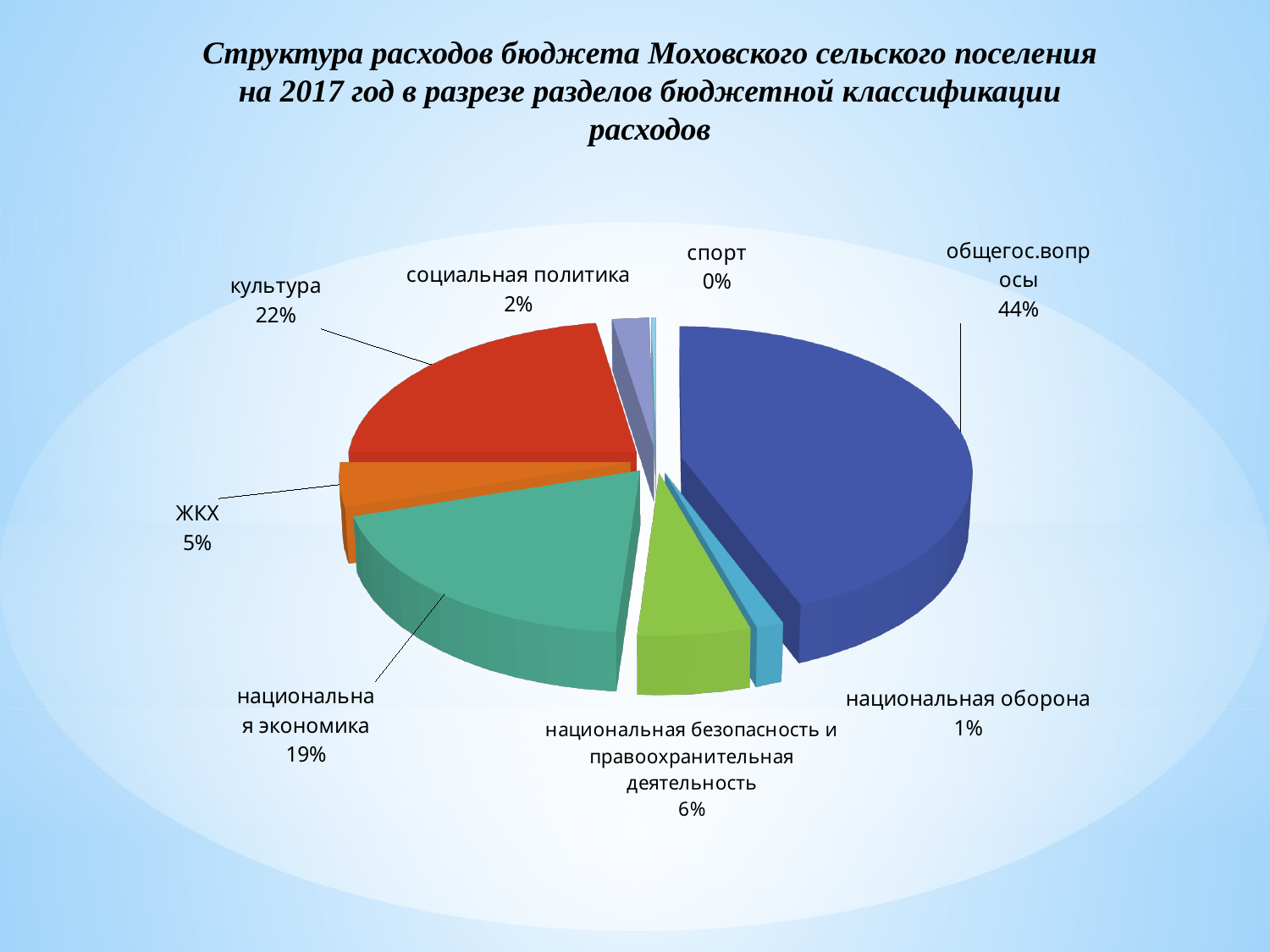
Which category has the smallest share of the pie? спорт What share of the budget expenditure goes to национальная экономика? 19% What share is shown for социальная политика? 2% What is the difference in percentage points between общегос.вопросы and культура? 22 Which category has the largest share of the pie? общегос.вопросы What kind of chart is shown on the slide? pie chart What share of the budget expenditure goes to культура? 22% Which is larger, the share for национальная экономика or the share for ЖКХ? национальная экономика How many categories are shown in the pie chart? 8 What share of the budget expenditure goes to общегос.вопросы? 44% What share is shown for национальная безопасность и правоохранительная деятельность? 6% What share is shown for ЖКХ? 5%